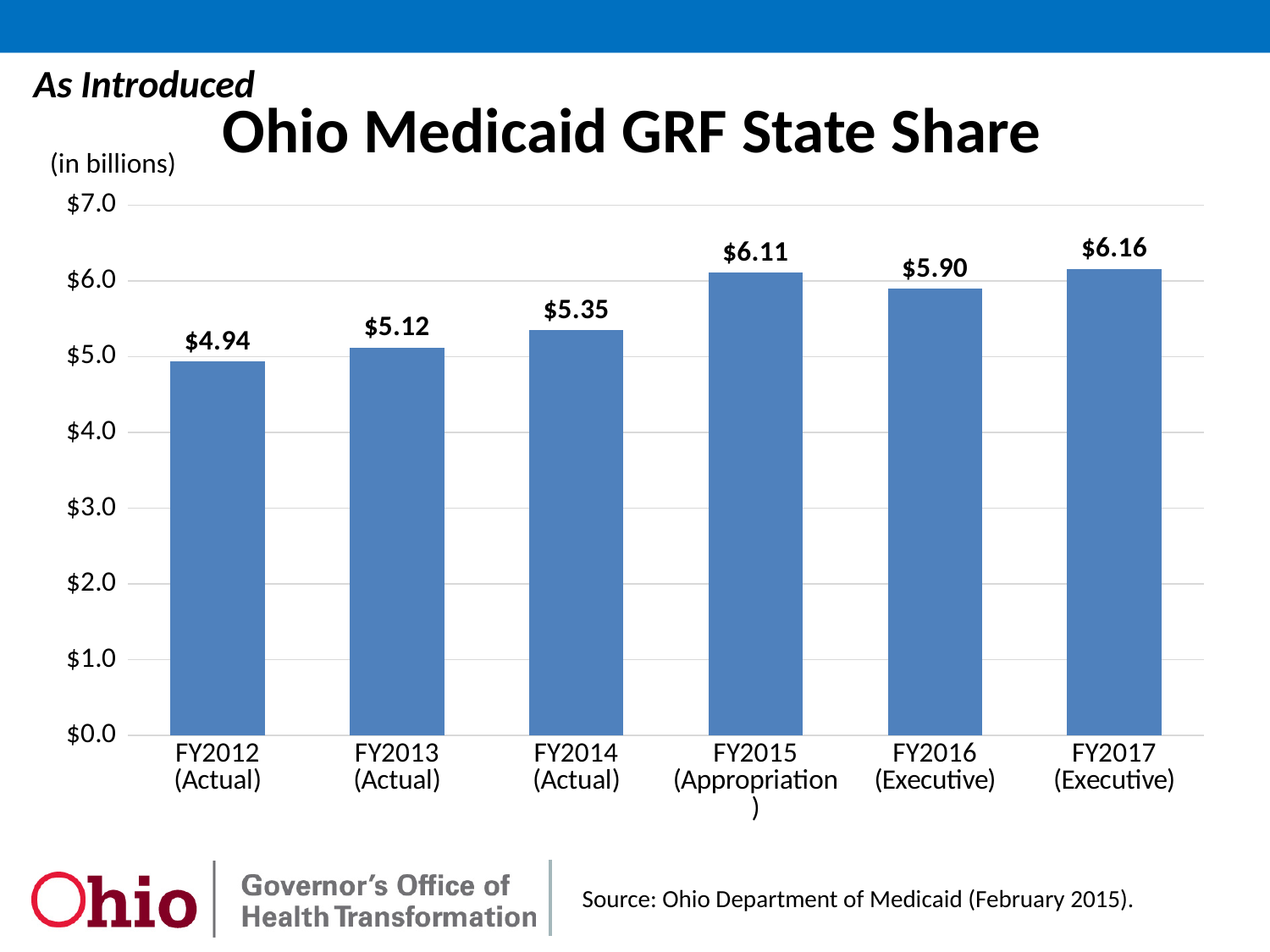
In what units are the values on the chart expressed? in billions Which fiscal year has the lowest value? FY2012 (Actual) What is the value for FY2012 (Actual)? $4.94 What is the difference between the FY2014 (Actual) and FY2013 (Actual) values? $0.23 What kind of chart is shown on the slide? bar chart Which is larger, the value for FY2015 (Appropriation) or FY2016 (Executive)? FY2015 (Appropriation) Which fiscal year has the highest value? FY2017 (Executive) Is the value for FY2014 (Actual) greater or less than $5.0? greater How many fiscal years are shown on the chart? 6 What is the value for FY2016 (Executive)? $5.90 What is the value for FY2015 (Appropriation)? $6.11 What is the title of the chart? Ohio Medicaid GRF State Share